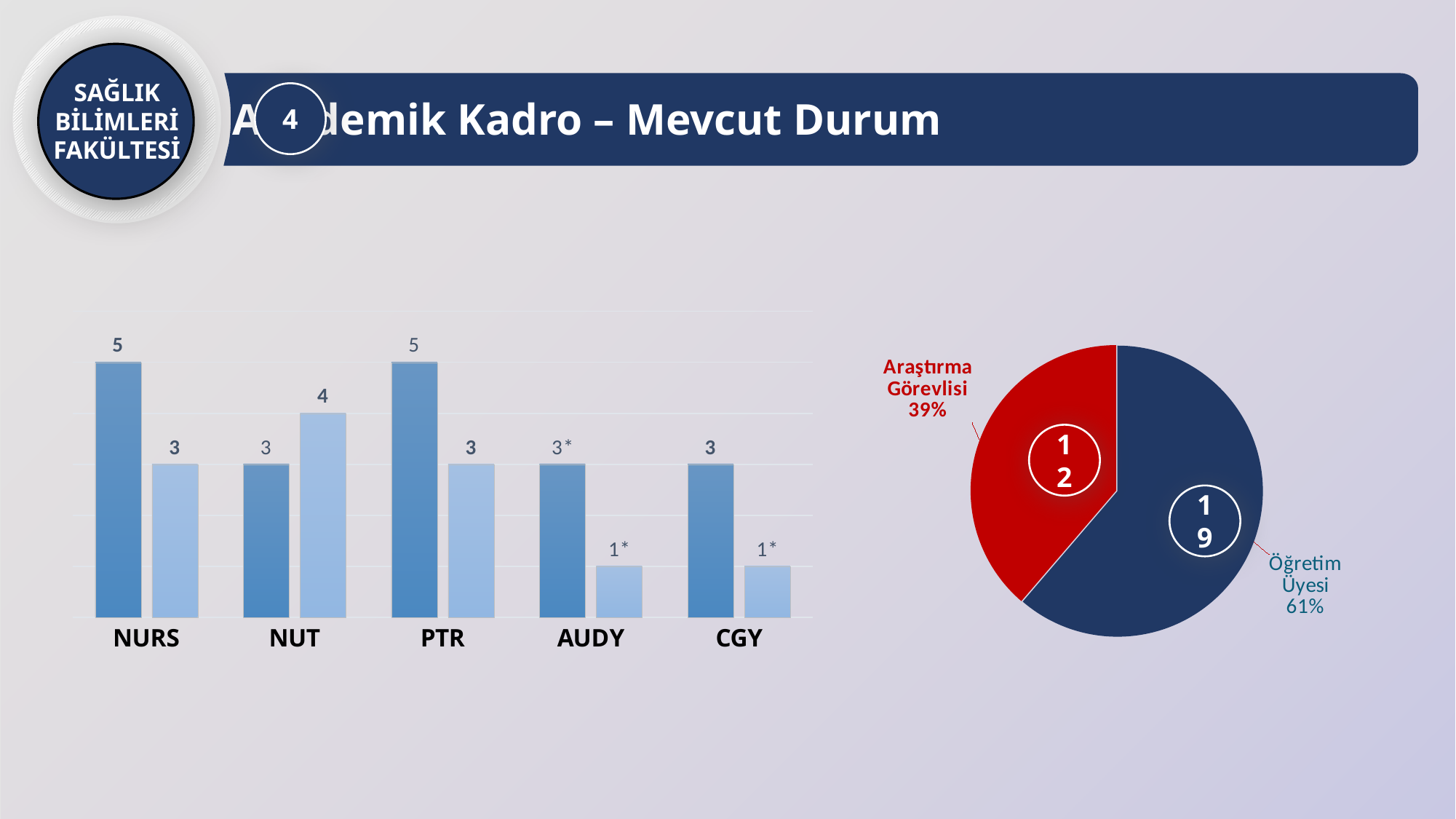
On the pie chart on the right, what share does Araştırma Görevlisi have? 39% On the bar chart on the left, what is the difference between the darker blue bar and the lighter blue bar for PTR? 2 On the bar chart on the left, what is the value of the lighter blue bar for AUDY? 1* On the bar chart on the left, which is larger for NUT: the darker blue bar or the lighter blue bar? the lighter blue bar On the pie chart on the right, what is the value shown for Öğretim Üyesi? 19 On the pie chart on the right, which slice is larger: Araştırma Görevlisi or Öğretim Üyesi? Öğretim Üyesi What kind of chart is shown on the left of the slide? bar chart On the bar chart on the left, what is the value of the darker blue bar for CGY? 3 On the bar chart on the left, what is the value of the darker blue bar for NURS? 5 On the bar chart on the left, what is the value of the lighter blue bar for NUT? 4 On the bar chart on the left, how many categories are shown on the x axis? 5 On the pie chart on the right, what colour is the Araştırma Görevlisi slice? red